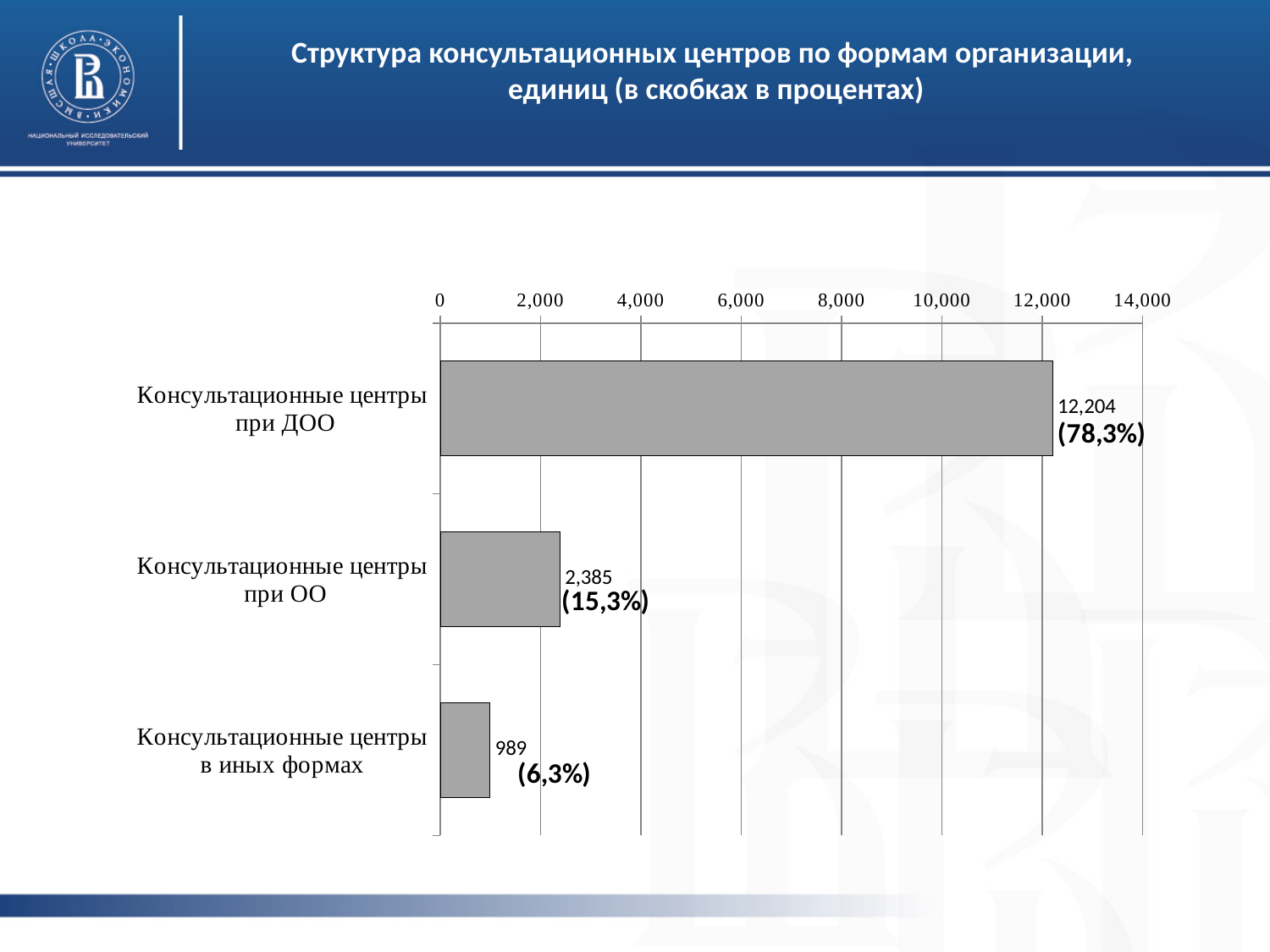
What percentage share is shown for Консультационные центры в иных формах? 6,3% What percentage share is shown for Консультационные центры при ОО? 15,3% How many categories are shown in the chart? 3 What is the difference between the values for Консультационные центры при ДОО and Консультационные центры при ОО? 9,819 What is the value for Консультационные центры при ДОО? 12,204 Which category has the lowest value? Консультационные центры в иных формах Which is larger: the value for Консультационные центры при ОО or for Консультационные центры в иных формах? Консультационные центры при ОО What is the value for Консультационные центры в иных формах? 989 Which category has the highest value? Консультационные центры при ДОО What kind of chart is shown on the slide? bar chart Is the value for Консультационные центры при ДОО greater or less than 12,000? greater What is the value for Консультационные центры при ОО? 2,385